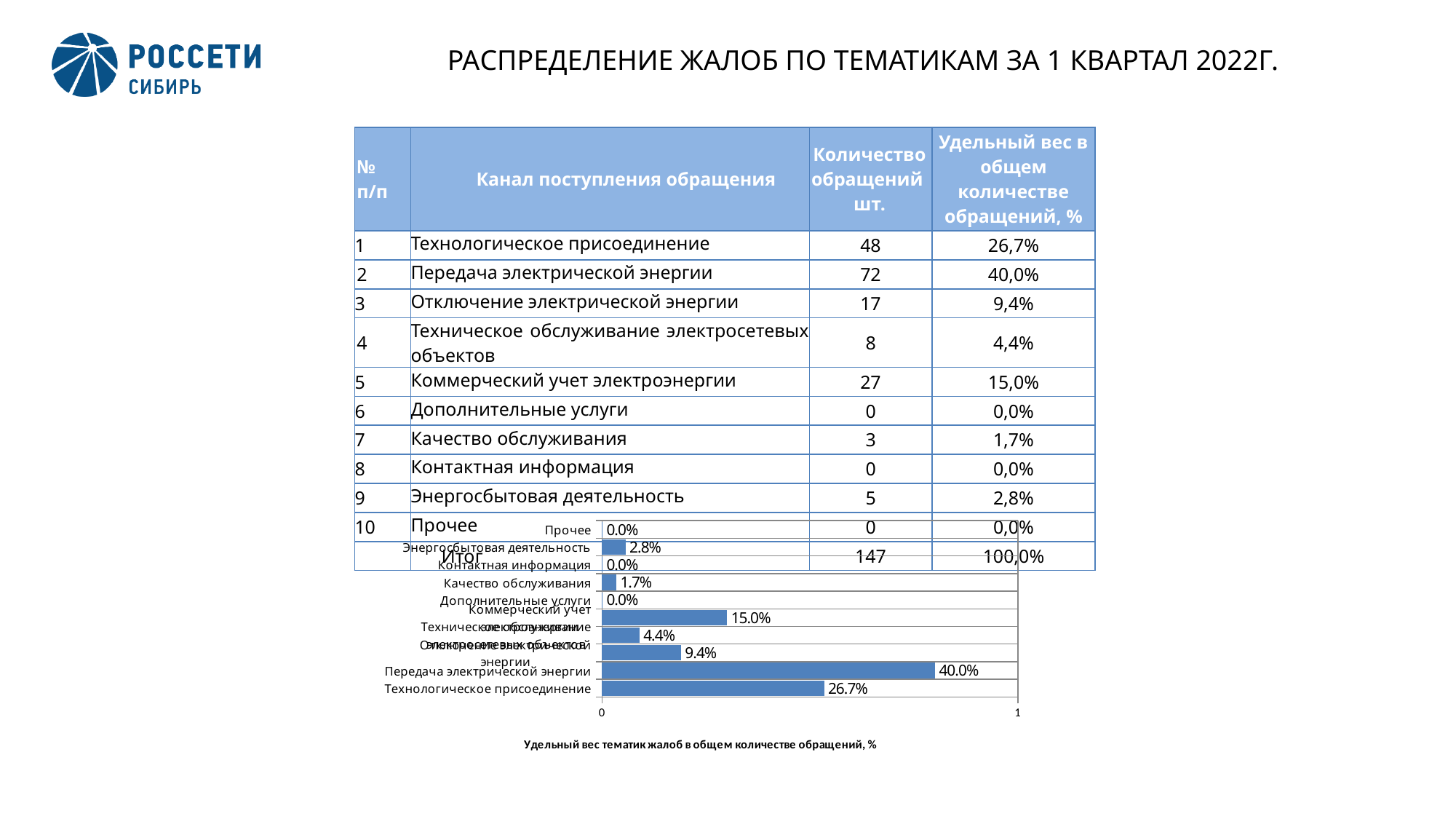
Which category has the highest value in the bar chart? Передача электрической энергии In the bar chart, what is the value for Передача электрической энергии? 40.0% In the bar chart, what is the value for Коммерческий учет электроэнергии? 15.0% In the bar chart, which is larger: Коммерческий учет электроэнергии or Энергосбытовая деятельность? Коммерческий учет электроэнергии What is the difference between the values for Передача электрической энергии and Технологическое присоединение in the bar chart? 13.3% What kind of chart is shown on the slide? bar chart What is the title of the bar chart? Удельный вес тематик жалоб в общем количестве обращений, % In the bar chart, what is the value for Качество обслуживания? 1.7% In the bar chart, what is the value for Энергосбытовая деятельность? 2.8% How many categories in the bar chart have a value of 0.0%? 3 How many categories are shown in the bar chart? 10 In the bar chart, what is the value for Технологическое присоединение? 26.7%